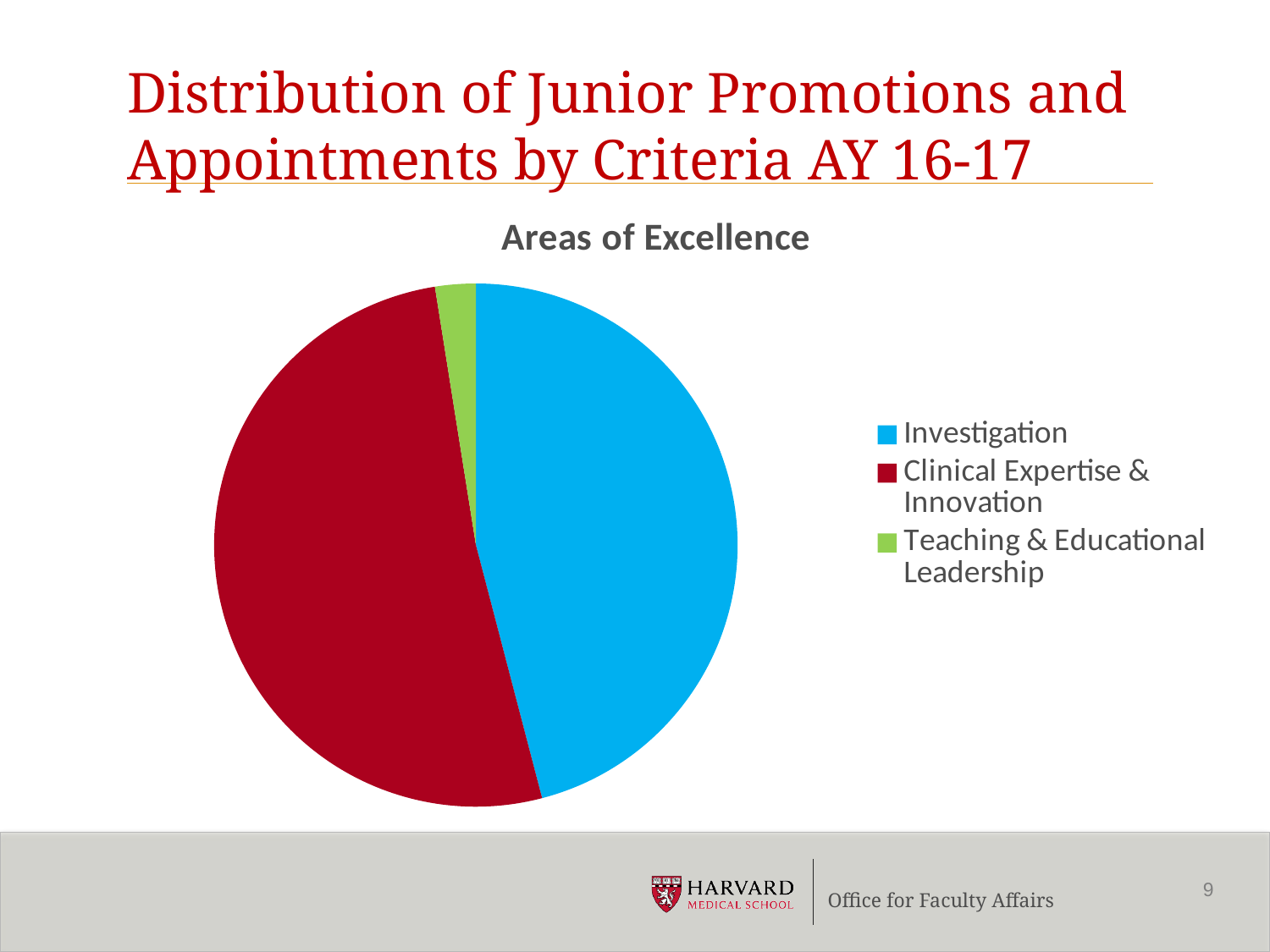
What kind of chart is shown on the slide? Pie chart Which colour represents Clinical Expertise & Innovation in the pie chart? Red Which slice is larger: Investigation or Teaching & Educational Leadership? Investigation What is the title of the pie chart? Areas of Excellence How many slices does the pie chart have? 3 Which area of excellence has the smallest slice in the pie chart? Teaching & Educational Leadership Which slice is larger: Clinical Expertise & Innovation or Teaching & Educational Leadership? Clinical Expertise & Innovation How many entries does the legend of the pie chart list? 3